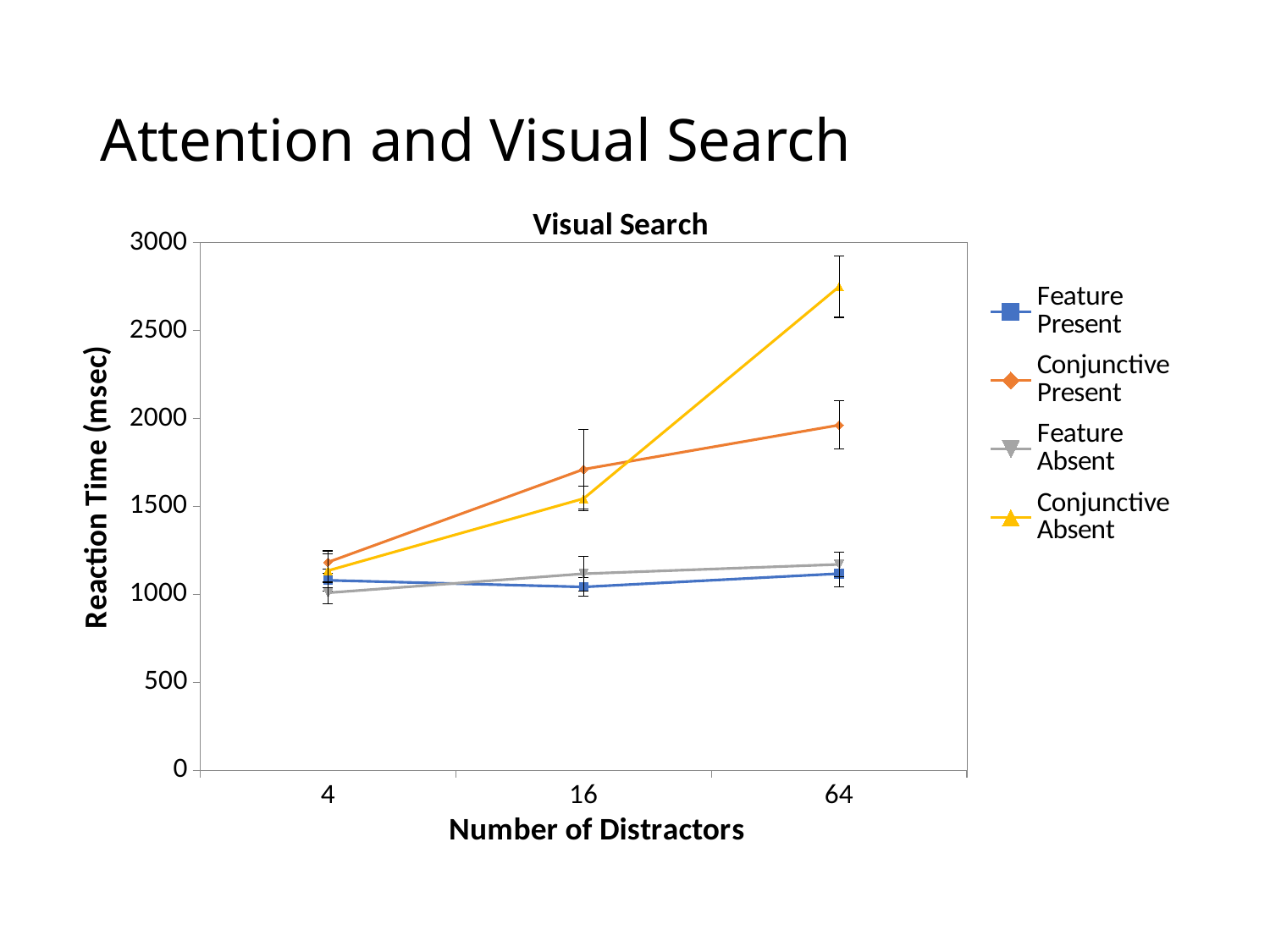
Is the reaction time for Conjunctive Absent at 64 distractors greater or less than 2500? greater What kind of chart is shown on the slide? line chart What is the title of the chart? Visual Search How many series does the legend list? 4 What is the label of the y axis? Reaction Time (msec) Is the reaction time for Feature Present at 64 distractors greater or less than 1500? less Which series has the highest reaction time at 16 distractors? Conjunctive Present How many values of Number of Distractors are plotted on the x axis? 3 Does the reaction time for Conjunctive Absent rise or fall as the number of distractors increases? rise At 64 distractors, which is larger: the reaction time for Conjunctive Present or for Feature Absent? Conjunctive Present Which series has the highest reaction time at 64 distractors? Conjunctive Absent Is the reaction time for Conjunctive Present at 16 distractors greater or less than 1500? greater